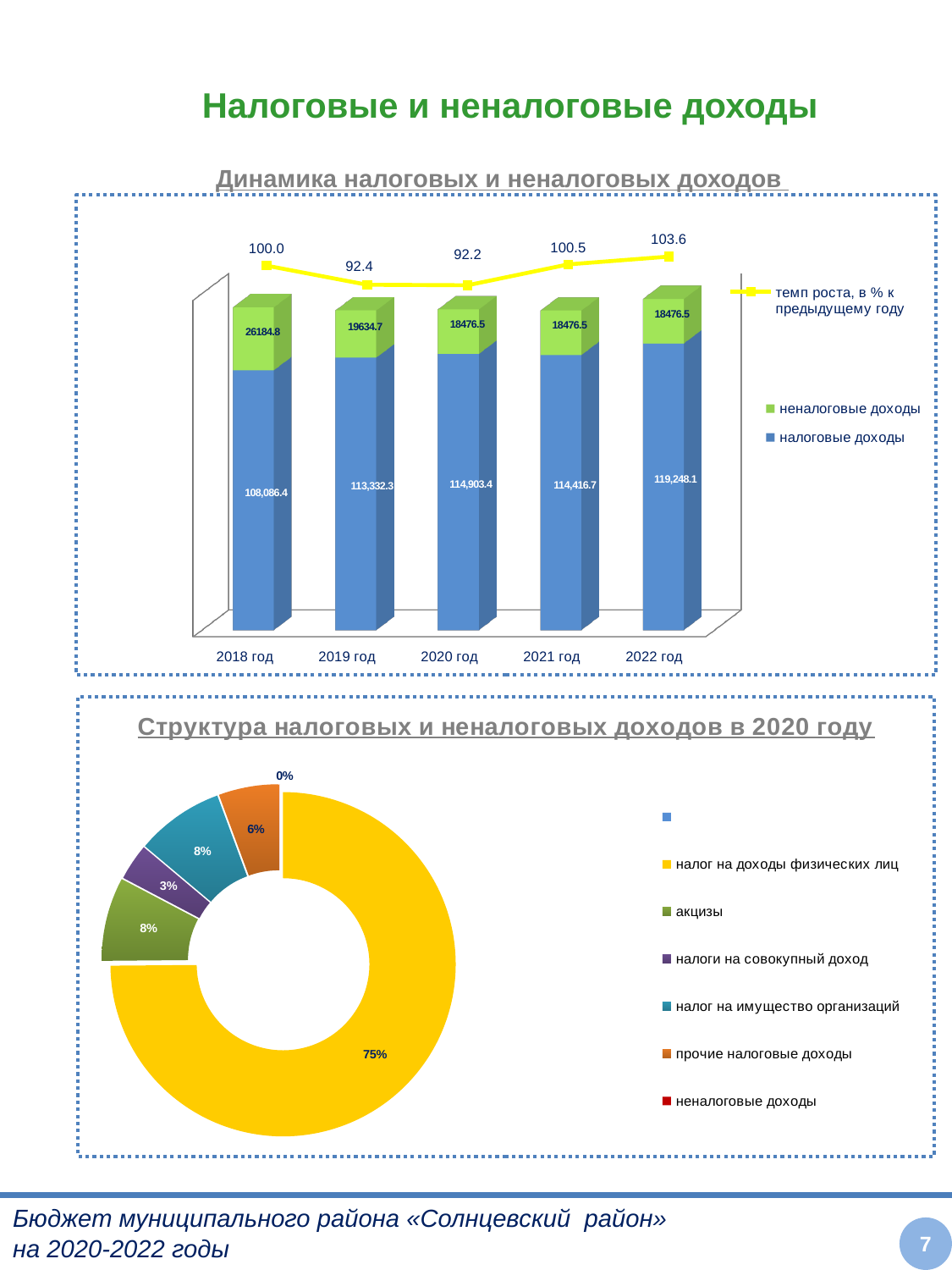
In the chart 'Динамика налоговых и неналоговых доходов', which year has the lowest value of налоговые доходы? 2018 год In the chart 'Динамика налоговых и неналоговых доходов', what is the difference between налоговые доходы in 2022 год and 2018 год? 11,161.7 In the chart 'Динамика налоговых и неналоговых доходов', what is the value of налоговые доходы for 2022 год? 119,248.1 What kind of chart is 'Структура налоговых и неналоговых доходов в 2020 году'? pie (donut) chart In the chart 'Динамика налоговых и неналоговых доходов', which year has the highest темп роста? 2022 год In the chart 'Динамика налоговых и неналоговых доходов', what is the темп роста value for 2019 год? 92.4 In the chart 'Структура налоговых и неналоговых доходов в 2020 году', what share is налог на доходы физических лиц? 75% In the chart 'Структура налоговых и неналоговых доходов в 2020 году', what share is прочие налоговые доходы? 6% In the chart 'Динамика налоговых и неналоговых доходов', what is the value of неналоговые доходы for 2018 год? 26184.8 In the chart 'Динамика налоговых и неналоговых доходов', what is the total of the stacked bar for 2018 год? 134,271.2 How many series does the legend of the chart 'Динамика налоговых и неналоговых доходов' list? 3 How many years are shown on the x axis of the chart 'Динамика налоговых и неналоговых доходов'? 5